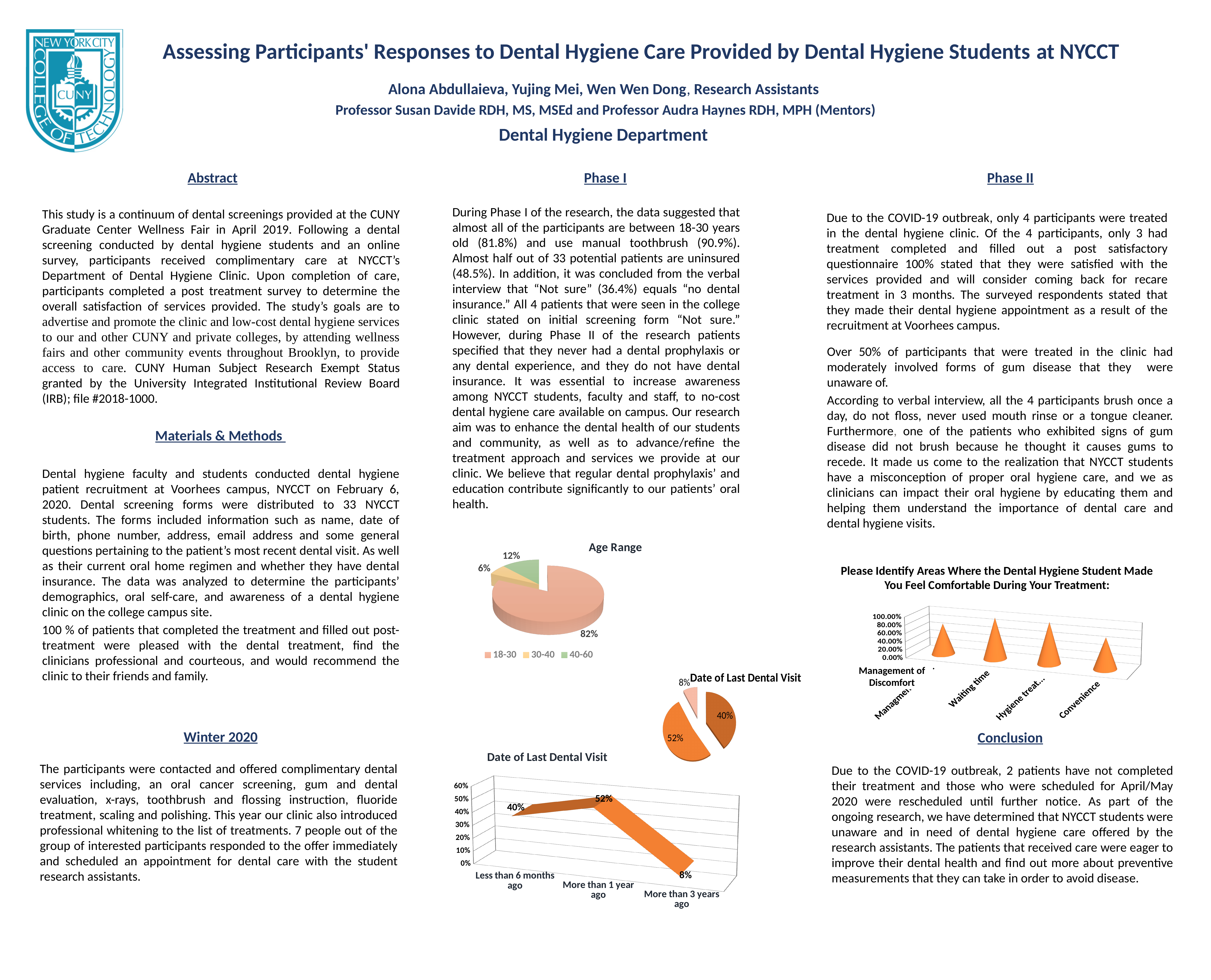
How many age groups does the legend of the Age Range chart list? 3 In the Age Range pie chart, which age group has the largest slice? 18-30 In the Date of Last Dental Visit line chart at the bottom centre, what is the value for 'Less than 6 months ago'? 40% In the Age Range pie chart, what share of participants are aged 18-30? 82% In the Date of Last Dental Visit line chart at the bottom centre, what is the value for 'More than 3 years ago'? 8% What kind of chart is the Age Range chart? Pie chart In the Date of Last Dental Visit line chart at the bottom centre, what is the difference between 'More than 1 year ago' and 'Less than 6 months ago'? 12% How many categories are shown on the x axis of the chart titled 'Please Identify Areas Where the Dental Hygiene Student Made You Feel Comfortable During Your Treatment'? 4 In the Age Range pie chart, what share of participants are aged 40-60? 12% In the Age Range pie chart, what share of participants are aged 30-40? 6% In the Age Range pie chart, which age group has the smallest slice? 30-40 In the Date of Last Dental Visit line chart at the bottom centre, what is the value for 'More than 1 year ago'? 52%